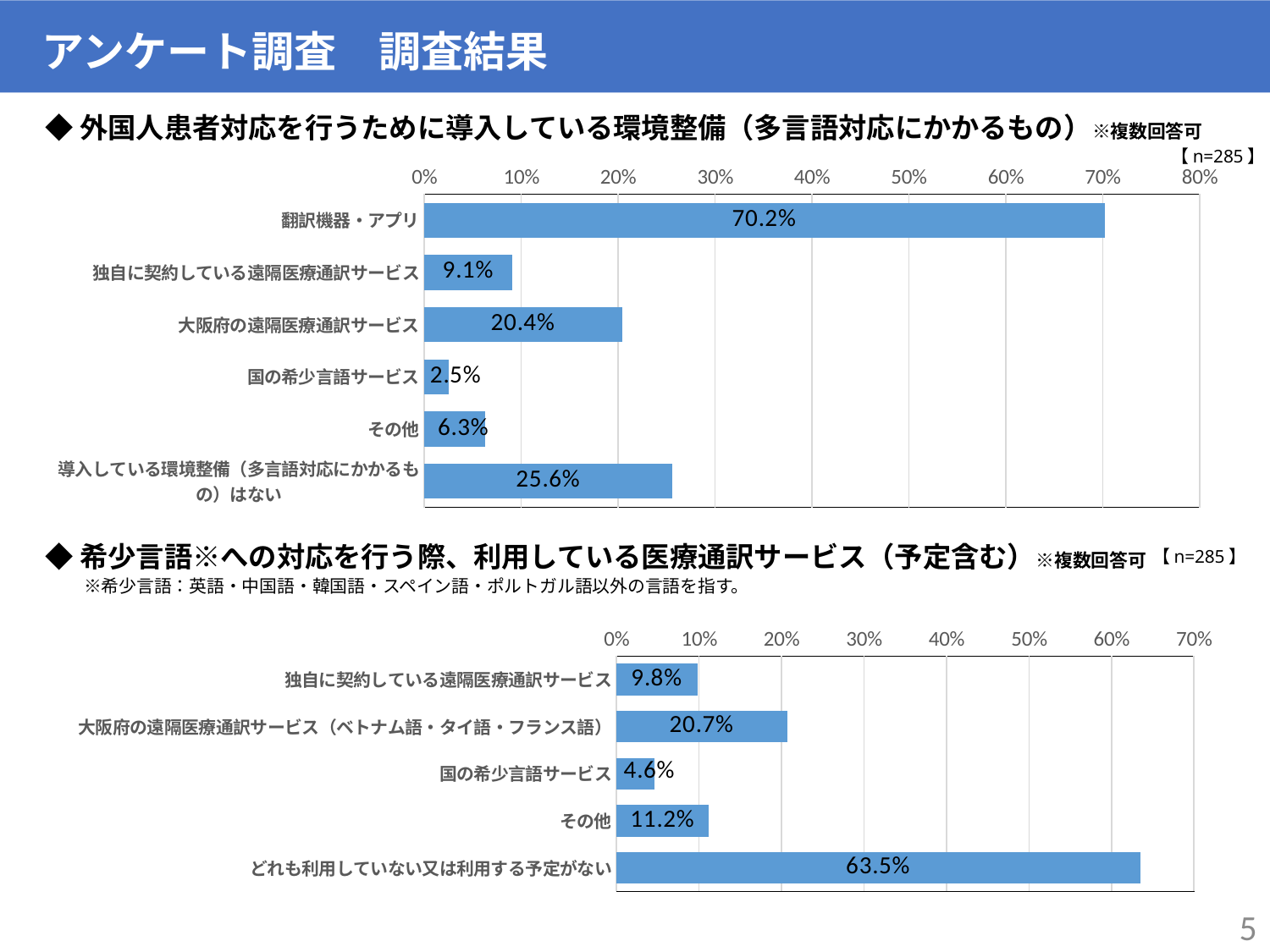
In the top chart, what is the value for 大阪府の遠隔医療通訳サービス? 20.4% In the top chart, which is larger: 独自に契約している遠隔医療通訳サービス or その他? 独自に契約している遠隔医療通訳サービス In the bottom chart, how many categories are shown? 5 In the bottom chart, what is the difference between 大阪府の遠隔医療通訳サービス（ベトナム語・タイ語・フランス語） and 独自に契約している遠隔医療通訳サービス? 10.9% In the top chart, how many categories are shown? 6 In the top chart, which category has the lowest value? 国の希少言語サービス In the bottom chart, which category has the highest value? どれも利用していない又は利用する予定がない In the bottom chart (希少言語への対応を行う際、利用している医療通訳サービス), what is the value for どれも利用していない又は利用する予定がない? 63.5% In the top chart (外国人患者対応を行うために導入している環境整備), what is the value for 翻訳機器・アプリ? 70.2% In the top chart, what is the difference between 翻訳機器・アプリ and 導入している環境整備（多言語対応にかかるもの）はない? 44.6% What type of chart is the bottom chart? Bar chart In the bottom chart, what is the value for 国の希少言語サービス? 4.6%